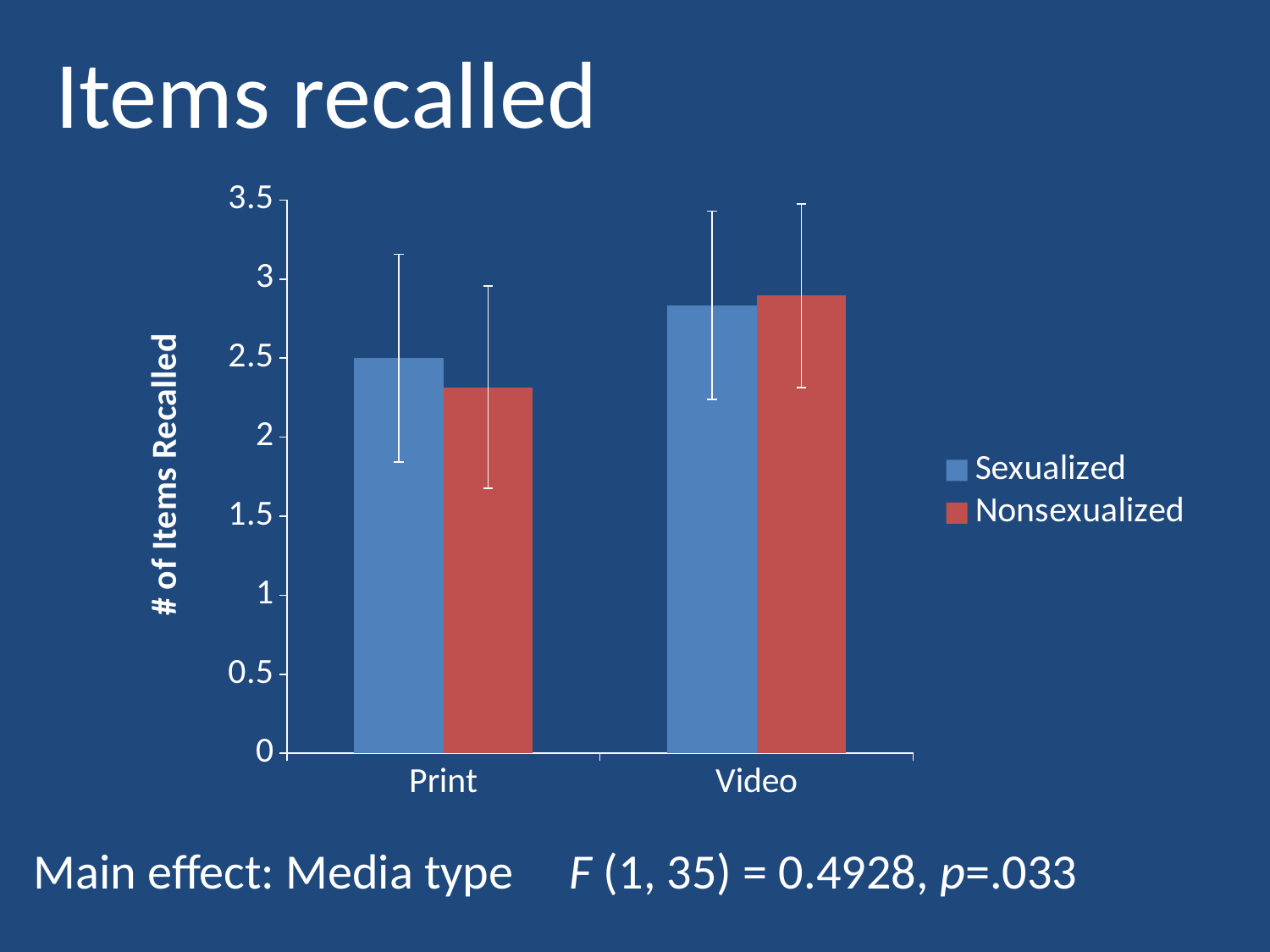
Is the Nonsexualized value for Video greater or less than 3? less For the Sexualized series, which category has the larger value, Print or Video? Video How many series does the legend list? 2 Is the Sexualized value for Print greater or less than 2? greater Is the Nonsexualized value for Print greater or less than 2.5? less What kind of chart is shown on the slide? bar chart How many categories are shown on the x axis? 2 What is the title of the y axis? # of Items Recalled Do the Nonsexualized values rise or fall from Print to Video? rise For Print, which series has the larger value, Sexualized or Nonsexualized? Sexualized Which bar has the lowest value on the chart? Nonsexualized for Print